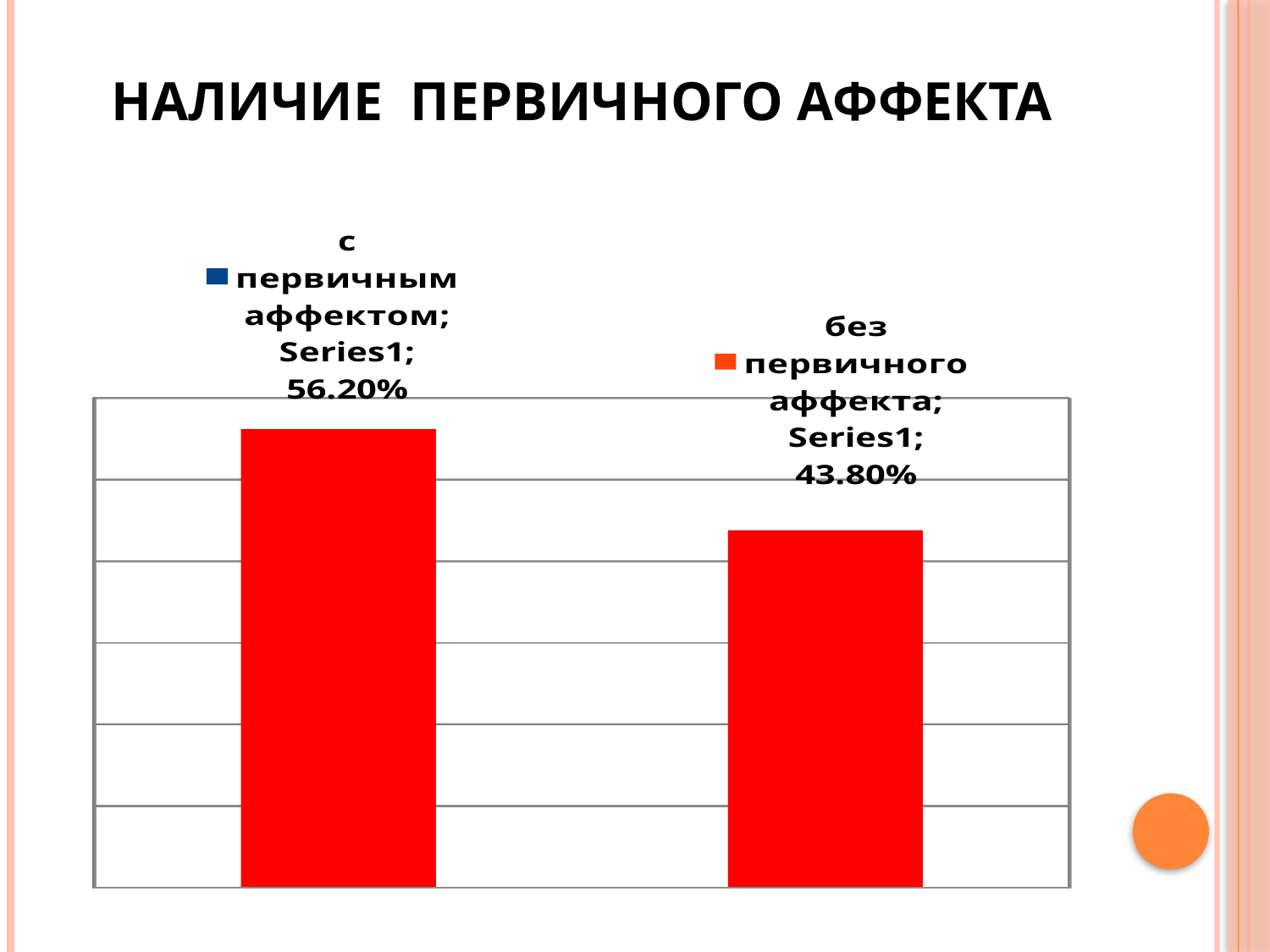
What colour are the bars in the chart? red What series name is shown in the data labels? Series1 What is the total of the two values shown in the chart? 100.00% What is the value for "без первичного аффекта"? 43.80% What kind of chart is shown on the slide? bar chart What is the title of the slide? НАЛИЧИЕ ПЕРВИЧНОГО АФФЕКТА Which is larger: the value for "с первичным аффектом" or for "без первичного аффекта"? с первичным аффектом How many bars are plotted in the chart? 2 Which category has the lowest value? без первичного аффекта Which category has the highest value? с первичным аффектом What is the value for "с первичным аффектом"? 56.20% What is the difference between the values for "с первичным аффектом" and "без первичного аффекта"? 12.40%